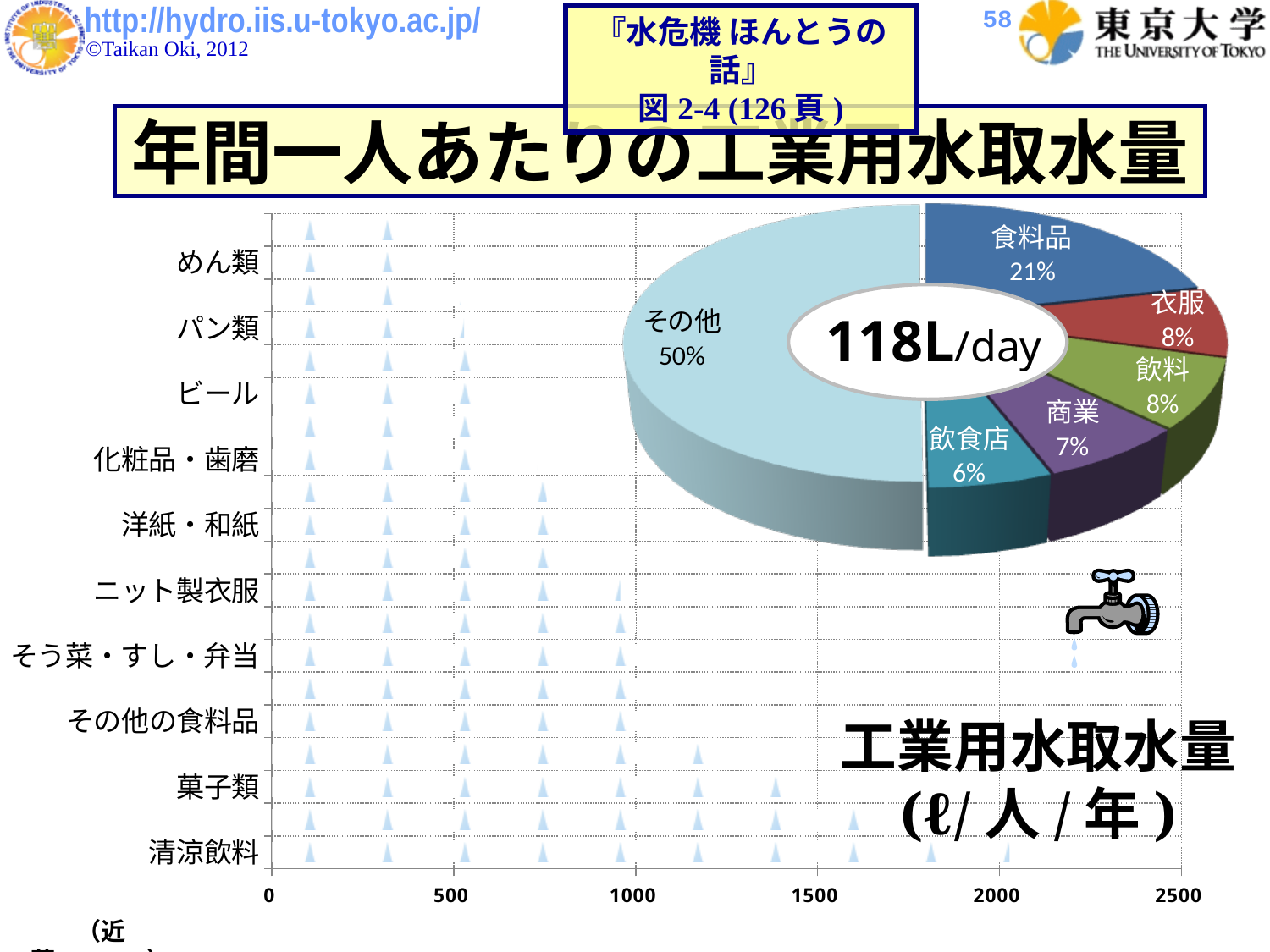
In the pie chart, which is larger, 商業 or 飲食店? 商業 In the pie chart, what is the difference in percentage points between 食料品 and 衣服? 13% In the pie chart, what share does その他 have? 50% What kind of chart is the chart on the right of the slide? pie chart How many slices does the pie chart have? 6 In the pie chart, which slice is the smallest? 飲食店 In the pie chart, what share does 食料品 have? 21% What value is printed in the centre of the pie chart? 118L/day How many categories are listed on the vertical axis of the chart on the left of the slide? 10 In the pie chart, which slice is the largest? その他 In the chart on the left of the slide, which category has the highest value? 清涼飲料